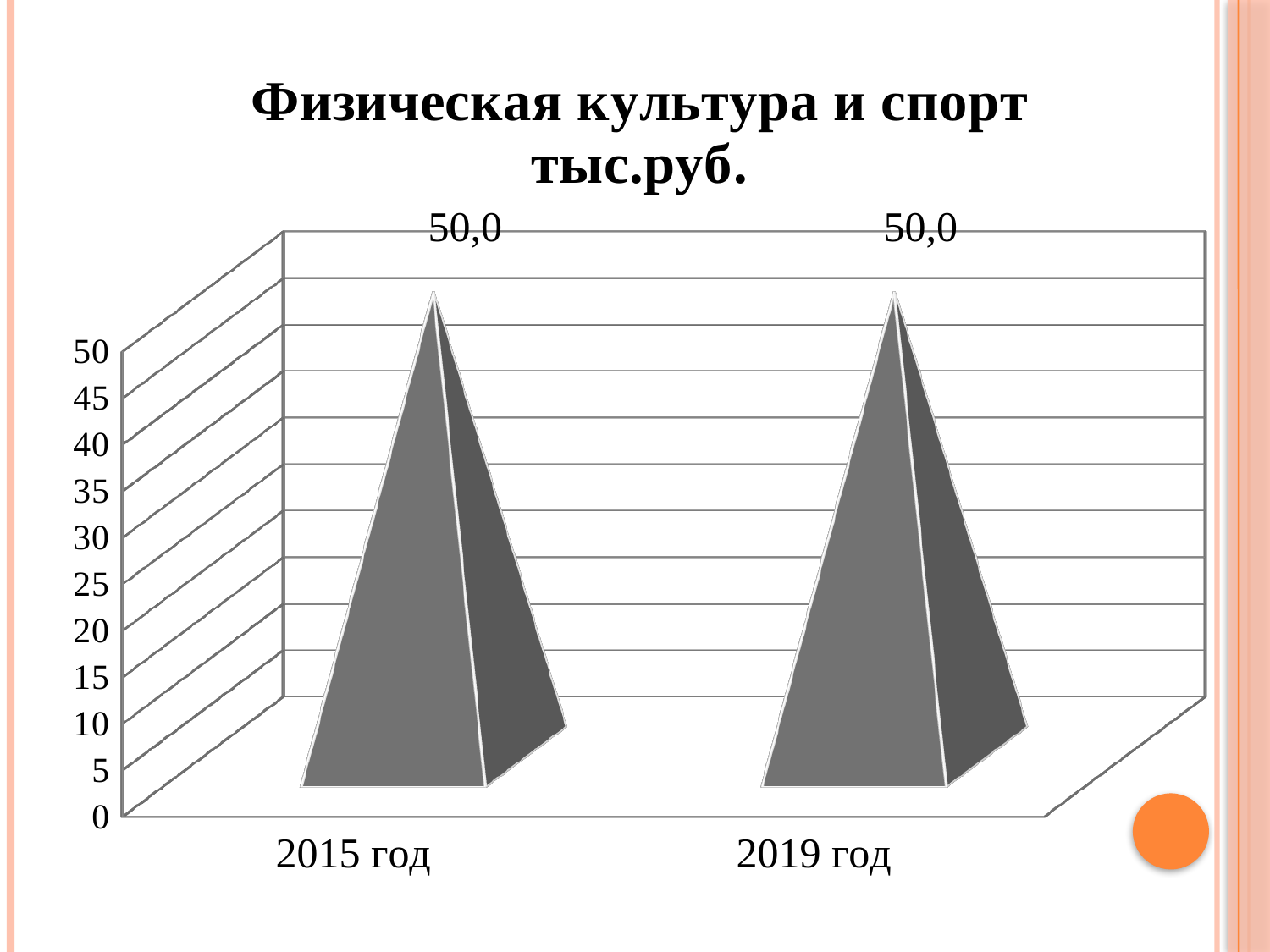
Do the values rise, fall, or stay the same from 2015 год to 2019 год? Stay the same What is the value for 2015 год? 50,0 What is the highest tick value shown on the vertical axis? 50 What is the total of the values for 2015 год and 2019 год? 100,0 What is the difference between the values for 2015 год and 2019 год? 0,0 What kind of chart is shown on the slide? Bar chart Is the value for 2015 год larger than, smaller than, or equal to the value for 2019 год? Equal How many categories are shown on the x axis? 2 What is the value for 2019 год? 50,0 Is the value for 2019 год greater or less than 40? greater What is the title of the chart? Физическая культура и спорт тыс.руб.